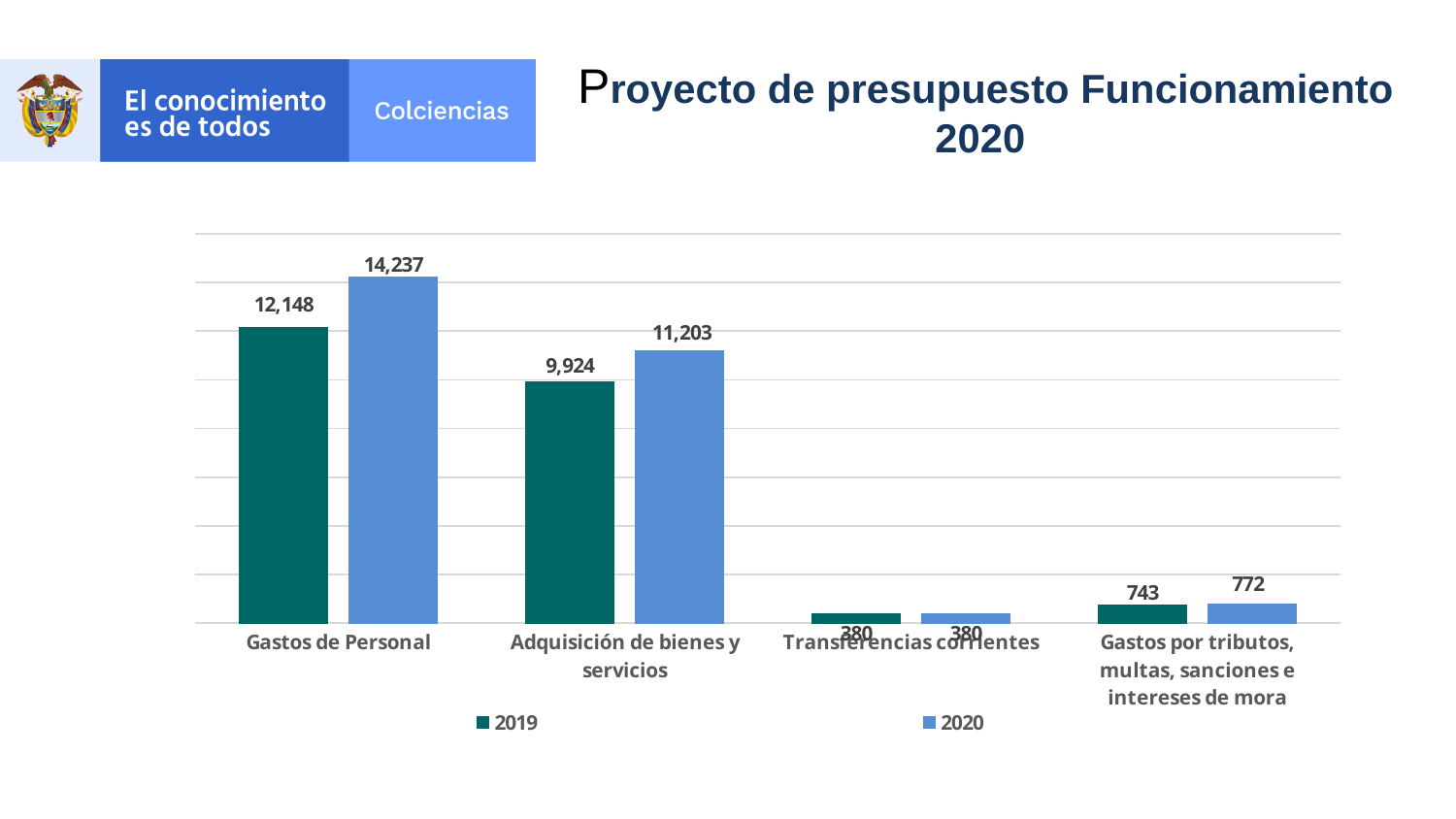
What is the difference between the 2020 and 2019 values for Gastos de Personal? 2,089 Which is larger for Gastos por tributos, multas, sanciones e intereses de mora: the 2019 value or the 2020 value? 2020 What is the 2020 value for Gastos por tributos, multas, sanciones e intereses de mora? 772 What is the 2020 value for Adquisición de bienes y servicios? 11,203 Which category has the highest 2020 value? Gastos de Personal How many series does the legend list? 2 What is the 2019 value for Transferencias corrientes? 380 What kind of chart is shown on the slide? Bar chart Which category has the lowest 2019 value? Transferencias corrientes What is the difference between the 2020 and 2019 values for Adquisición de bienes y servicios? 1,279 How many categories are shown on the x axis? 4 What is the 2019 value for Gastos de Personal? 12,148